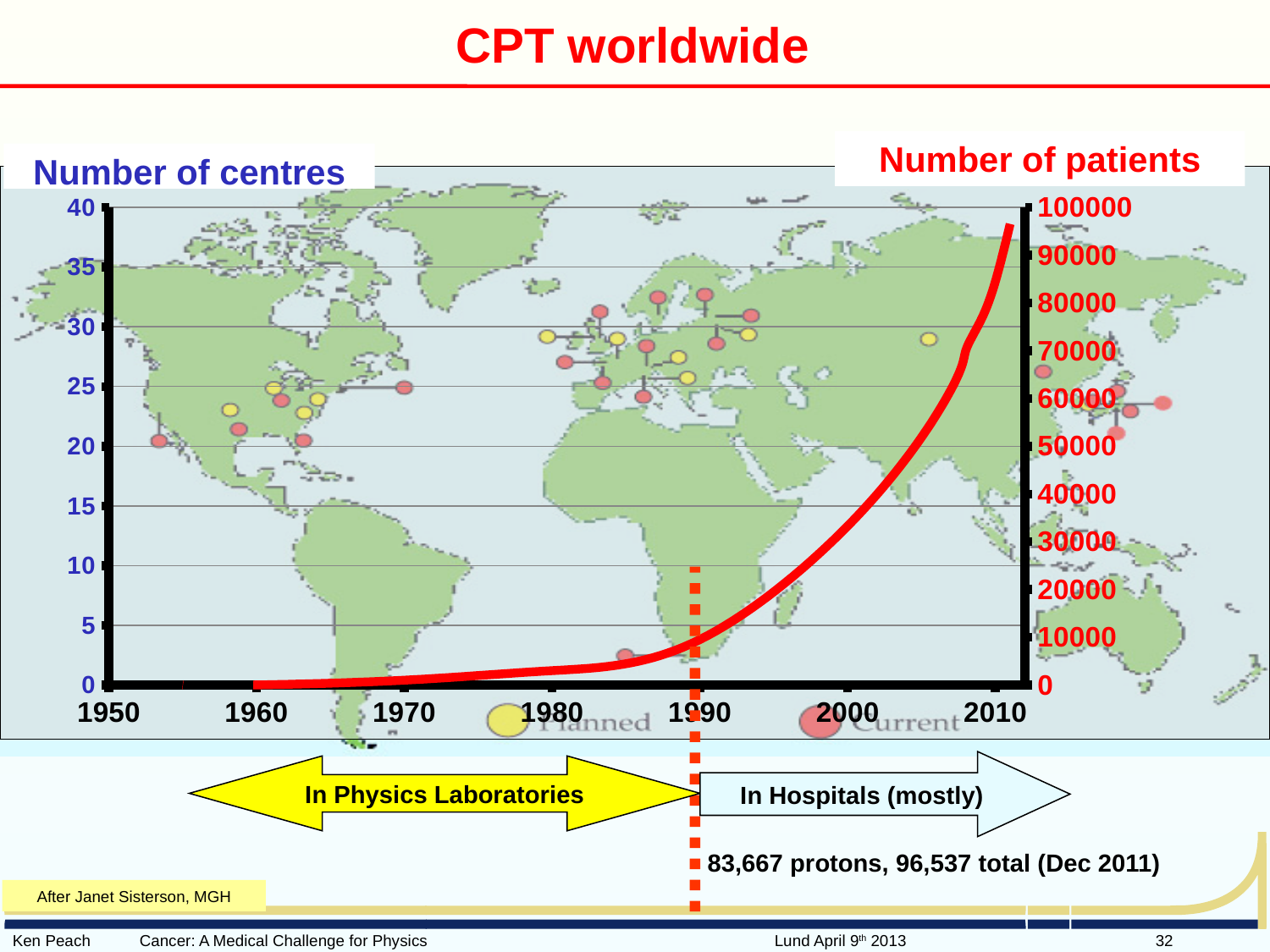
Is the number of patients in 1990 greater or less than 20000? less Which year is larger in number of patients, 2000 or 1990? 2000 Is the number of patients in 1980 greater or less than 10000? less Is the number of patients in 1970 greater or less than 10000? less What is the highest value shown on the right-hand (Number of patients) axis? 100000 Does the red curve for number of patients rise or fall from 1950 to 2010? rise What kind of chart is overlaid on the world map? line chart In which year shown on the x axis does the number of patients curve reach its highest value? 2010 What is the label of the left-hand axis of the chart? Number of centres How many year labels are shown along the x axis? 7